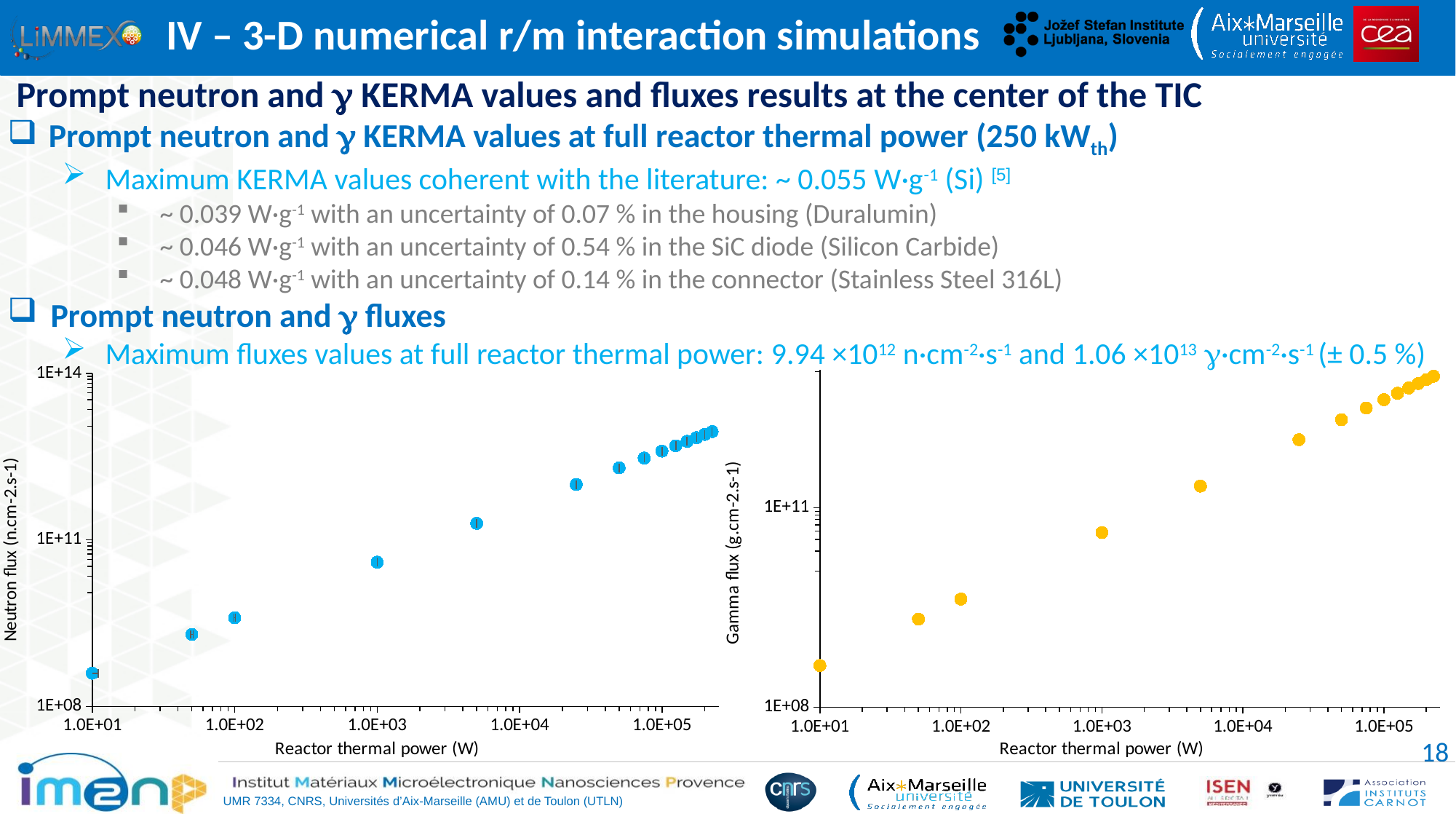
In the right chart, is the gamma flux at a reactor thermal power of 1.0E+01 W greater or less than 1E+11? less In the left chart, does the neutron flux rise or fall as reactor thermal power increases? Rises In the right chart, which is larger: the gamma flux at 1.0E+01 W or at 1.0E+03 W? 1.0E+03 W In the left chart, is the neutron flux at a reactor thermal power of 1.0E+01 W greater or less than 1E+11? less What kind of chart is the left chart showing neutron flux? Scatter chart In the right chart, does the gamma flux rise or fall as reactor thermal power increases? Rises What is the x-axis title of the left chart? Reactor thermal power (W) What is the y-axis title of the right chart? Gamma flux (g.cm-2.s-1) What kind of chart is the right chart showing gamma flux? Scatter chart